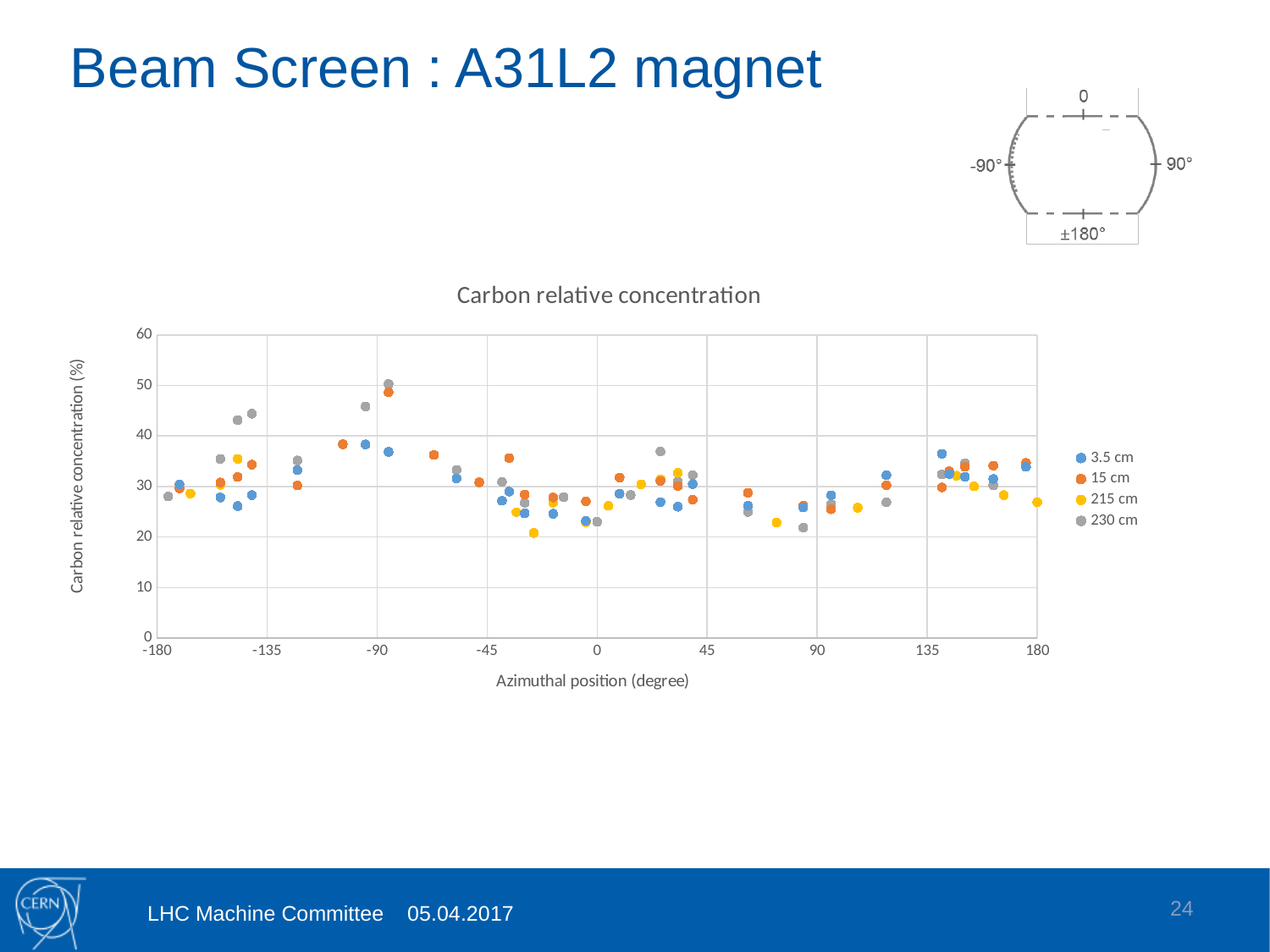
What is the label of the x axis of the chart? Azimuthal position (degree) Do the values of the 230 cm series rise or fall between about -85 degrees and 0 degrees? fall Is the highest value of the 230 cm series (near -85 degrees) greater or less than 40? greater Is the lowest value of the 215 cm series (near -30 degrees) greater or less than 30? less Is the value of the 230 cm series at about 85 degrees greater or less than 30? less At about -85 degrees, which series has the larger value: 230 cm or 3.5 cm? 230 cm What is the title of the chart? Carbon relative concentration How many series does the legend of the chart list? 4 What is the maximum value shown on the y axis of the chart? 60 Which series in the chart reaches the highest carbon relative concentration value? 230 cm What kind of chart is shown on the slide? scatter chart